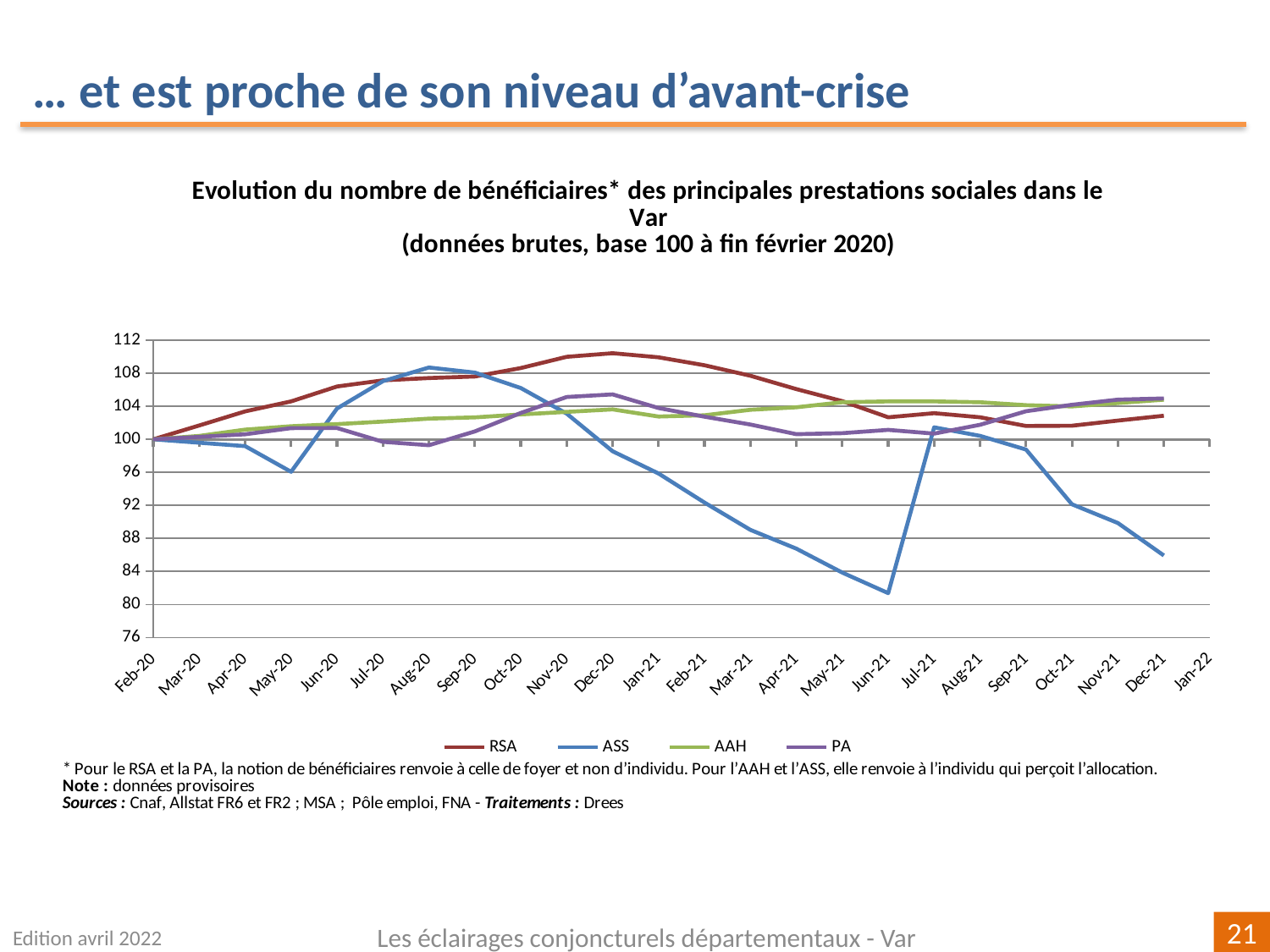
What kind of chart is shown on the slide? line chart Is the value for PA in Dec-21 greater or less than 104? greater What value do all four series share in Feb-20? 100 Is the value for RSA in Dec-20 greater or less than 108? greater Is the value for ASS in Dec-21 greater or less than 88? less Which is larger in Dec-21, the value for RSA or the value for ASS? RSA How many series does the legend list? 4 Which series is the lowest in Jun-21? ASS Does the ASS series rise or fall from Jul-21 to Dec-21? fall Which series is drawn in blue in the legend? ASS Which series is the highest in Dec-20? RSA